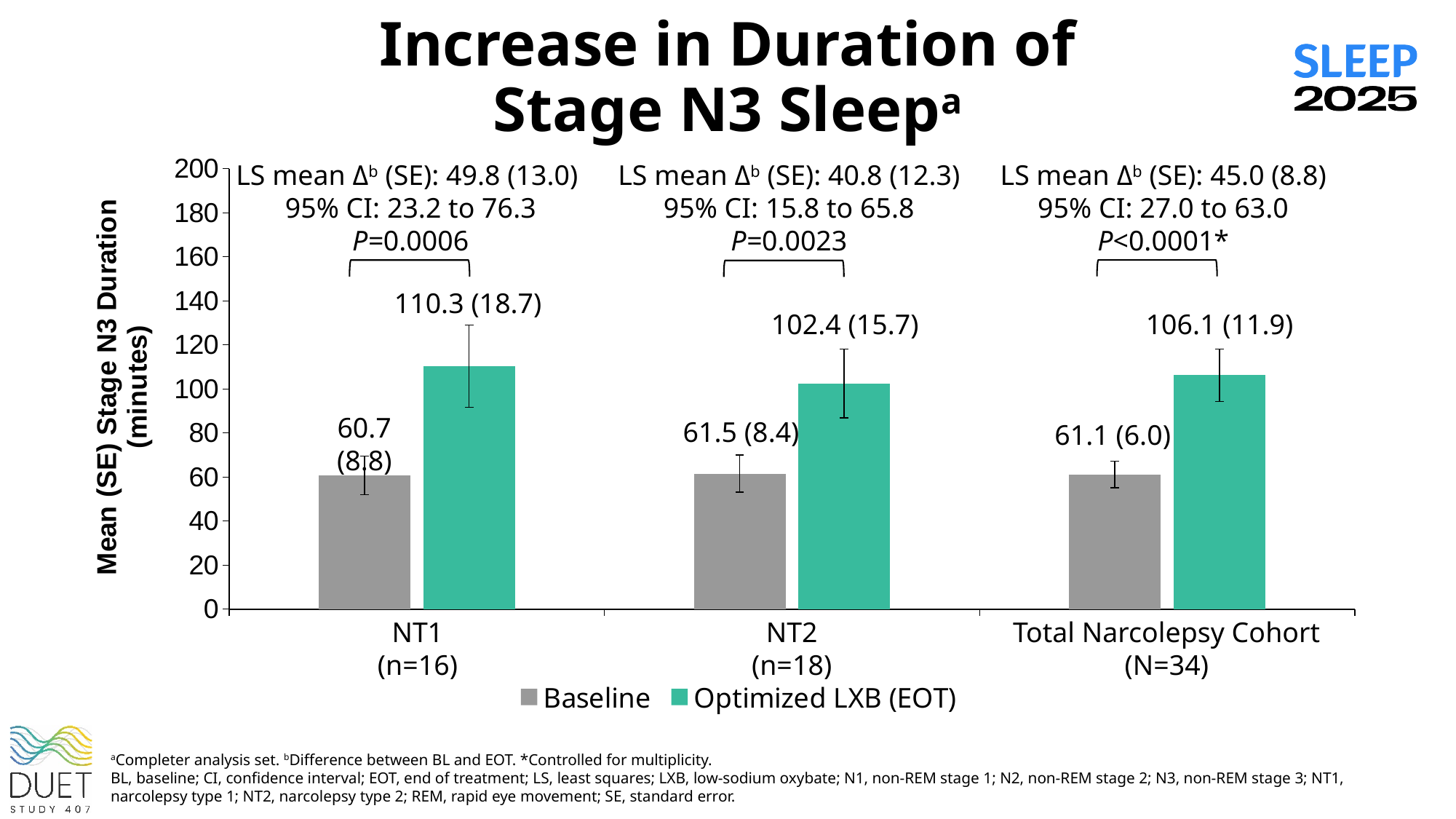
What kind of chart is shown on the slide? Bar chart What is the difference between the Optimized LXB (EOT) and Baseline mean Stage N3 duration for the Total Narcolepsy Cohort? 45.0 How many series does the chart legend list? 2 What is the difference between the Optimized LXB (EOT) and Baseline mean Stage N3 duration for the NT1 group? 49.6 Which group has the lowest mean Stage N3 duration at baseline? NT1 What is the mean (SE) Stage N3 duration with Optimized LXB (EOT) for the Total Narcolepsy Cohort? 106.1 (11.9) What is the mean (SE) Stage N3 duration at baseline for the NT1 group? 60.7 (8.8) How many groups are shown on the x axis of the chart? 3 What is the mean Stage N3 duration with Optimized LXB (EOT) for the NT2 group? 102.4 Which group has the highest mean Stage N3 duration with Optimized LXB (EOT)? NT1 Is the Baseline mean Stage N3 duration for the NT1 group greater or less than 80 minutes? less Which is larger for the NT2 group: the Baseline mean or the Optimized LXB (EOT) mean Stage N3 duration? Optimized LXB (EOT)